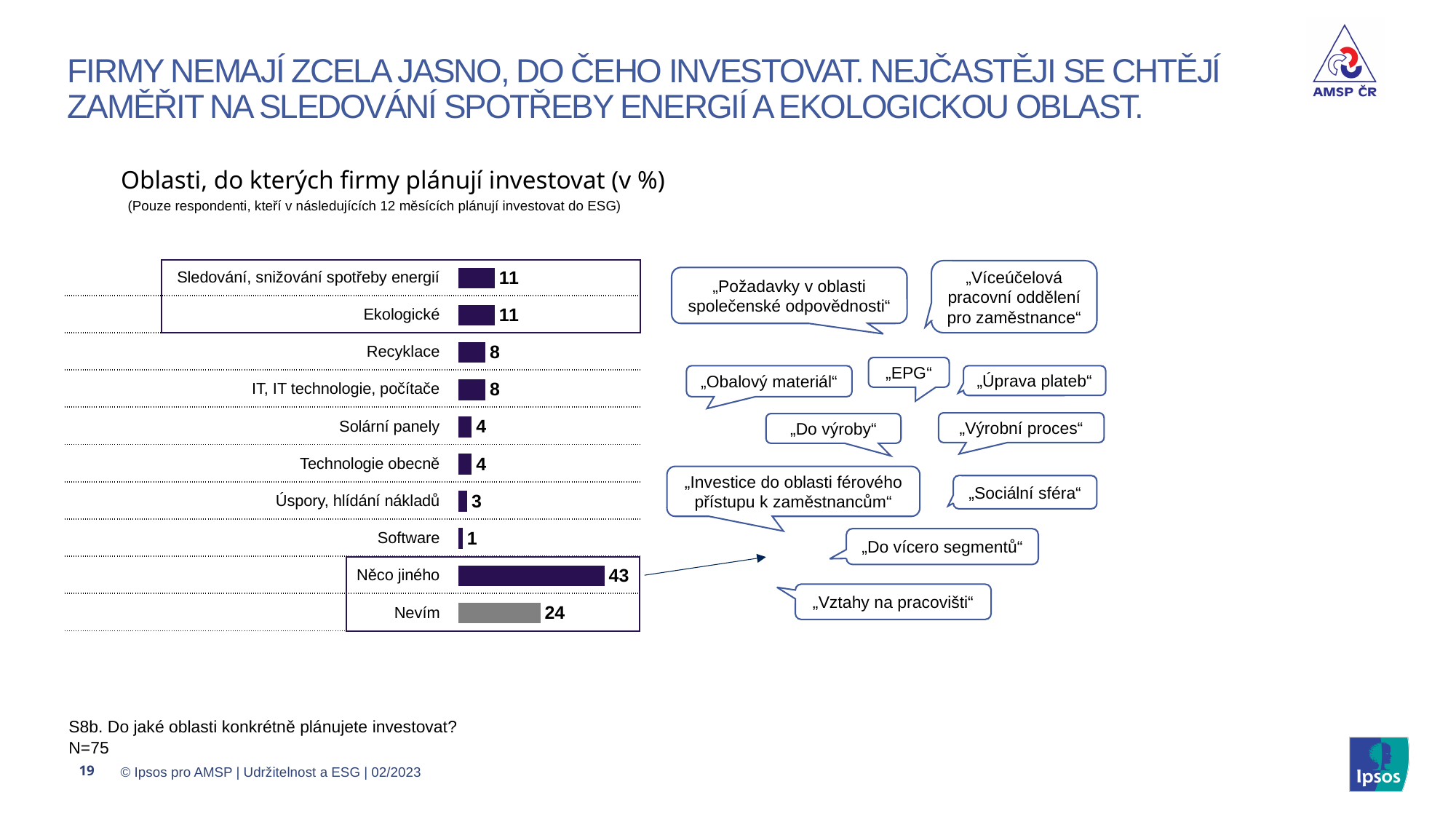
How many categories are shown in the chart? 10 What is the value for "Software"? 1 Which is larger, the value for "Úspory, hlídání nákladů" or the value for "IT, IT technologie, počítače"? IT, IT technologie, počítače Which category has the highest value? Něco jiného What is the value for "Něco jiného"? 43 What is the value for "Nevím"? 24 What kind of chart is shown on the slide? Bar chart What is the difference between the values for "Ekologické" and "Solární panely"? 7 What is the title of the chart? Oblasti, do kterých firmy plánují investovat (v %) What is the value for "Recyklace"? 8 Which category has the lowest value? Software What is the difference between the values for "Něco jiného" and "Nevím"? 19